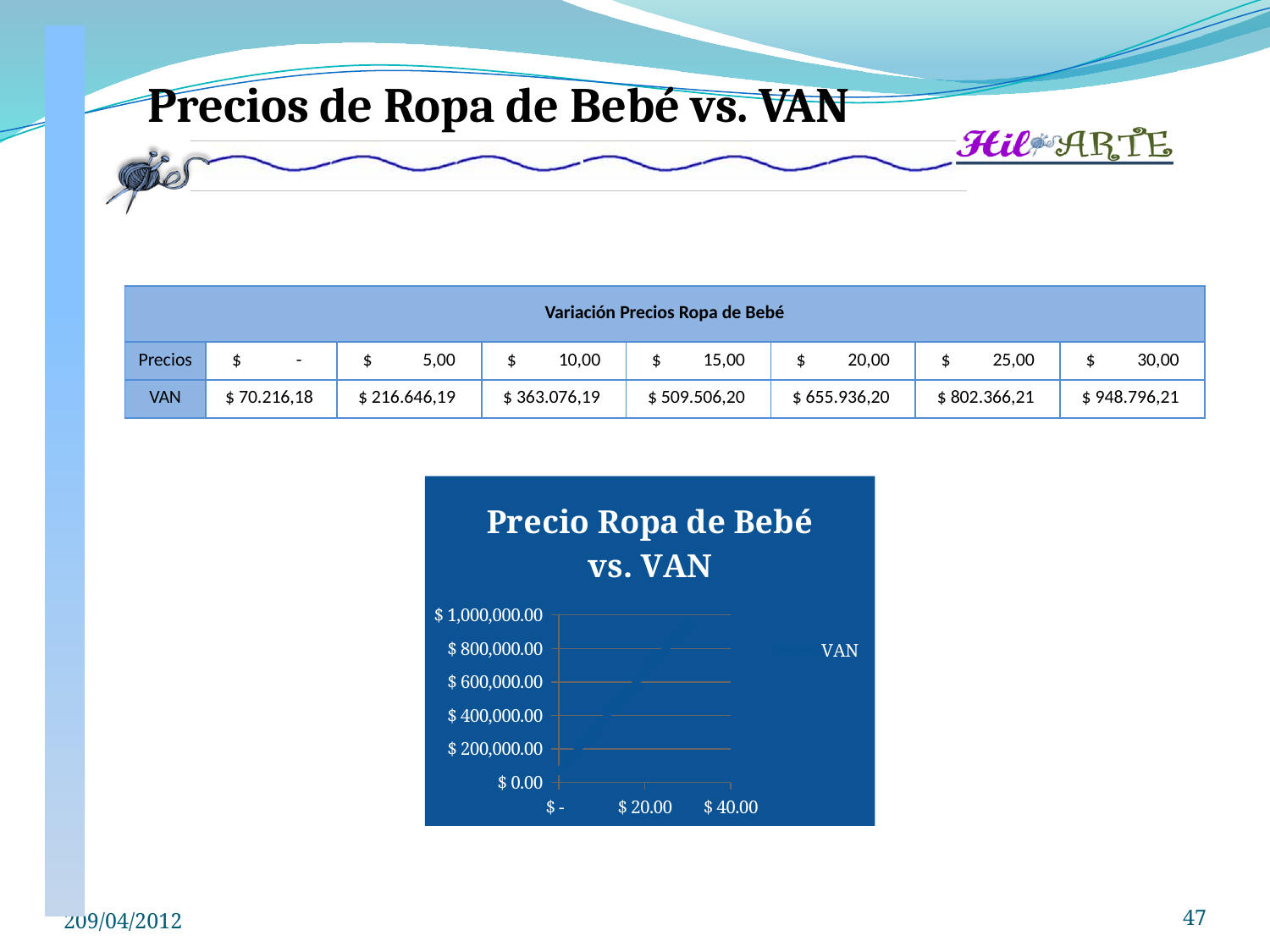
Is the VAN at a price of $20.00 greater or less than $600,000.00? greater How many price points are plotted for VAN? 7 Which price gives the highest VAN? $ 30,00 According to the table, what is the VAN when the price is $10,00? $ 363.076,19 Does the VAN rise or fall as the price increases along the x axis? rise What kind of chart is shown on the slide? line chart Is the VAN at a price of $0 greater or less than $200,000.00? less How many series does the chart's legend list? 1 What is the title of the chart on the slide? Precio Ropa de Bebé vs. VAN According to the table, what is the VAN when the price is $30,00? $ 948.796,21 Which price gives the lowest VAN? $ - What is the name of the series shown in the chart legend? VAN